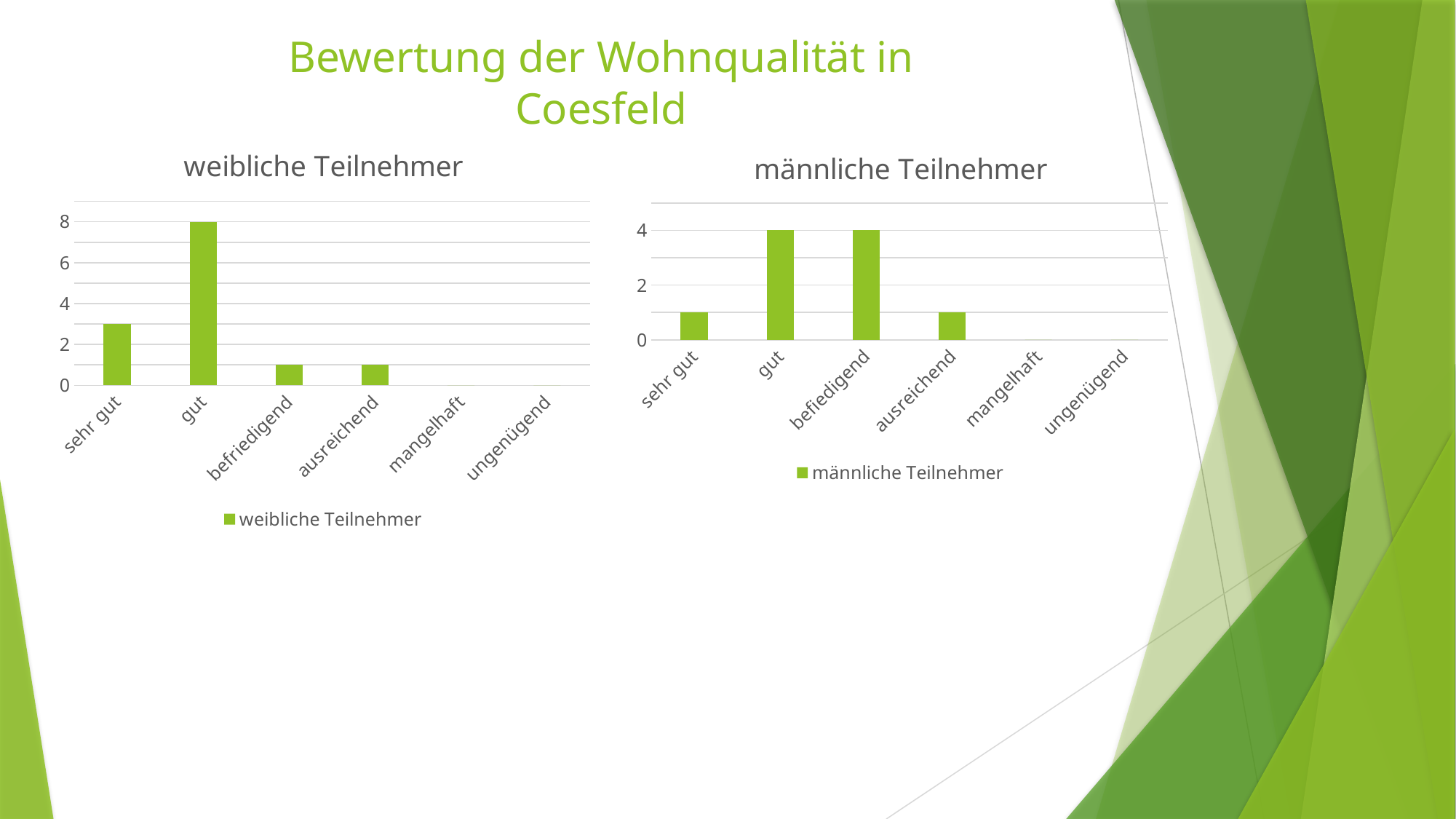
What kind of chart is the 'männliche Teilnehmer' chart? bar chart How many series does the legend of the 'weibliche Teilnehmer' chart list? 1 In the 'weibliche Teilnehmer' chart, what is the value for 'gut'? 8 In the 'weibliche Teilnehmer' chart, which is larger, the value for 'sehr gut' or the value for 'gut'? gut How many categories are shown on the x axis of the 'weibliche Teilnehmer' chart? 6 In the 'weibliche Teilnehmer' chart, is the value for 'sehr gut' greater or less than 2? greater In the 'männliche Teilnehmer' chart, what is the value for 'gut'? 4 In the 'weibliche Teilnehmer' chart, which category has the highest value? gut In the 'männliche Teilnehmer' chart, what is the value for 'befiedigend'? 4 In the 'männliche Teilnehmer' chart, is the value for 'ausreichend' greater or less than 2? less In the 'weibliche Teilnehmer' chart, is the value for 'befriedigend' greater or less than 2? less In the 'männliche Teilnehmer' chart, which is larger, the value for 'gut' or the value for 'ausreichend'? gut